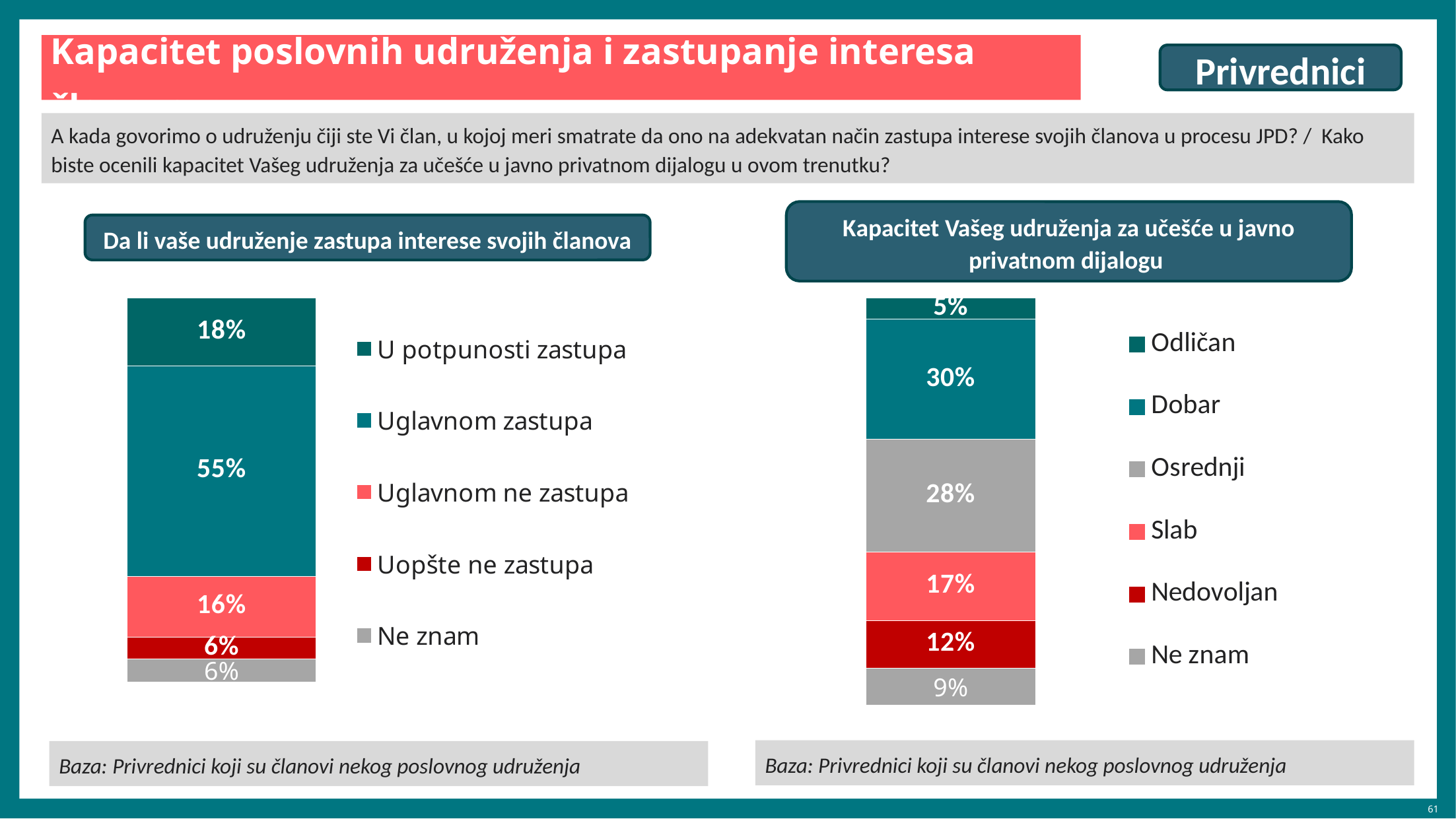
In the chart 'Kapacitet Vašeg udruženja za učešće u javno privatnom dijalogu', which is larger: 'Dobar' or 'Slab'? Dobar What kind of chart is used in 'Kapacitet Vašeg udruženja za učešće u javno privatnom dijalogu'? Stacked bar chart In the chart 'Kapacitet Vašeg udruženja za učešće u javno privatnom dijalogu', what is the difference between 'Dobar' and 'Odličan'? 25 percentage points In the chart 'Kapacitet Vašeg udruženja za učešće u javno privatnom dijalogu', which category has the lowest value? Odličan In the chart 'Da li vaše udruženje zastupa interese svojih članova', what is the value for 'Uglavnom zastupa'? 55% In the chart 'Da li vaše udruženje zastupa interese svojih članova', what is the difference between 'Uglavnom zastupa' and 'Uglavnom ne zastupa'? 39 percentage points In the chart 'Da li vaše udruženje zastupa interese svojih članova', how many series does the legend list? 5 In the chart 'Kapacitet Vašeg udruženja za učešće u javno privatnom dijalogu', what is the value for 'Osrednji'? 28% In the chart 'Da li vaše udruženje zastupa interese svojih članova', what is the value for 'U potpunosti zastupa'? 18% In the chart 'Da li vaše udruženje zastupa interese svojih članova', which category has the highest value? Uglavnom zastupa In the chart 'Kapacitet Vašeg udruženja za učešće u javno privatnom dijalogu', how many series does the legend list? 6 In the chart 'Kapacitet Vašeg udruženja za učešće u javno privatnom dijalogu', what is the value for 'Nedovoljan'? 12%